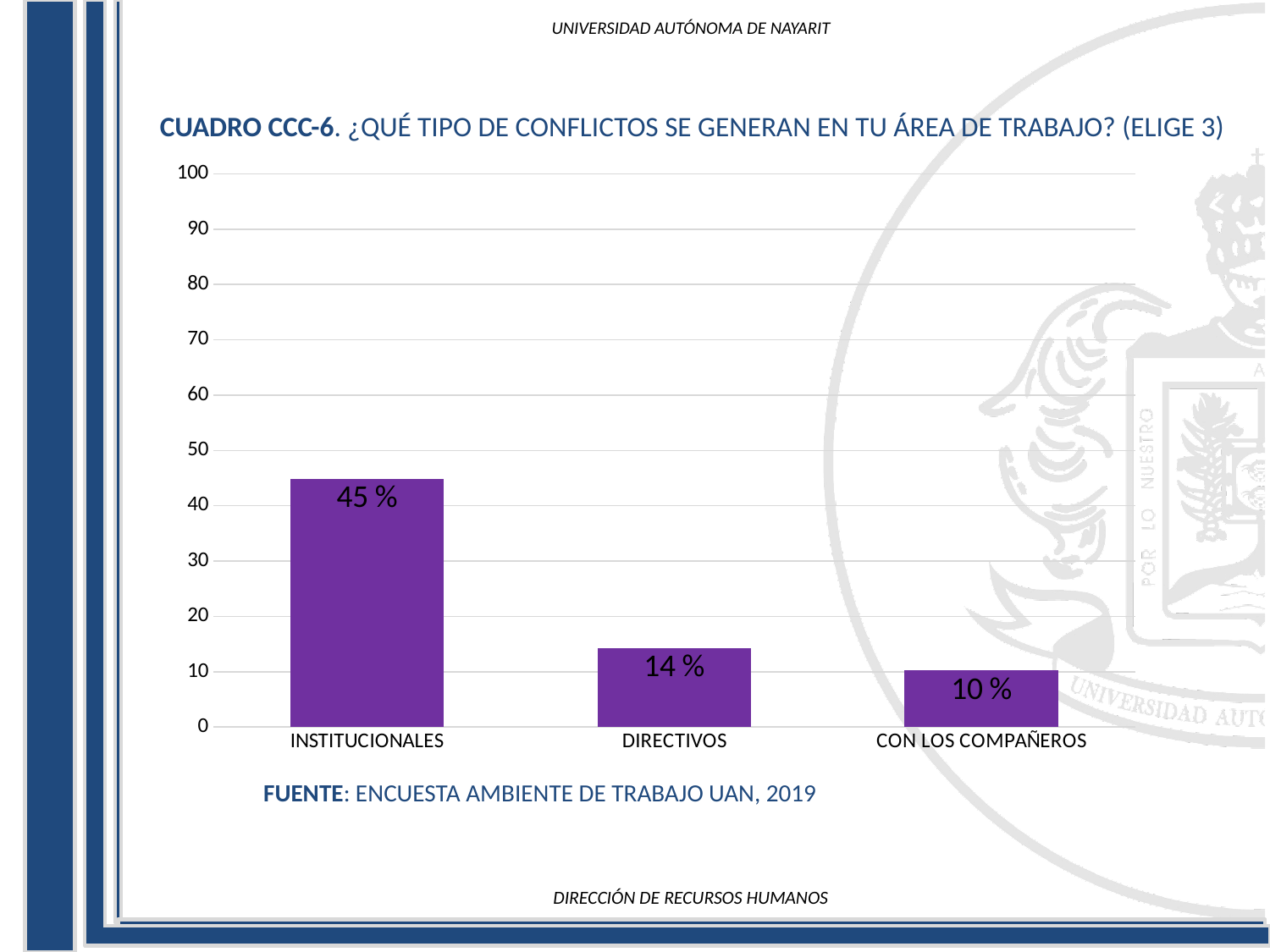
What source is cited below the chart? ENCUESTA AMBIENTE DE TRABAJO UAN, 2019 What is the difference between the values for INSTITUCIONALES and DIRECTIVOS? 31 % What kind of chart is shown on the slide? bar chart What is the value for DIRECTIVOS? 14 % What is the value for CON LOS COMPAÑEROS? 10 % How many categories are shown on the x axis? 3 Which is larger, the value for DIRECTIVOS or the value for CON LOS COMPAÑEROS? DIRECTIVOS Which category has the highest value? INSTITUCIONALES Which category has the lowest value? CON LOS COMPAÑEROS Is the value for INSTITUCIONALES greater or less than 50? less What is the value for INSTITUCIONALES? 45 % What is the difference between the values for DIRECTIVOS and CON LOS COMPAÑEROS? 4 %